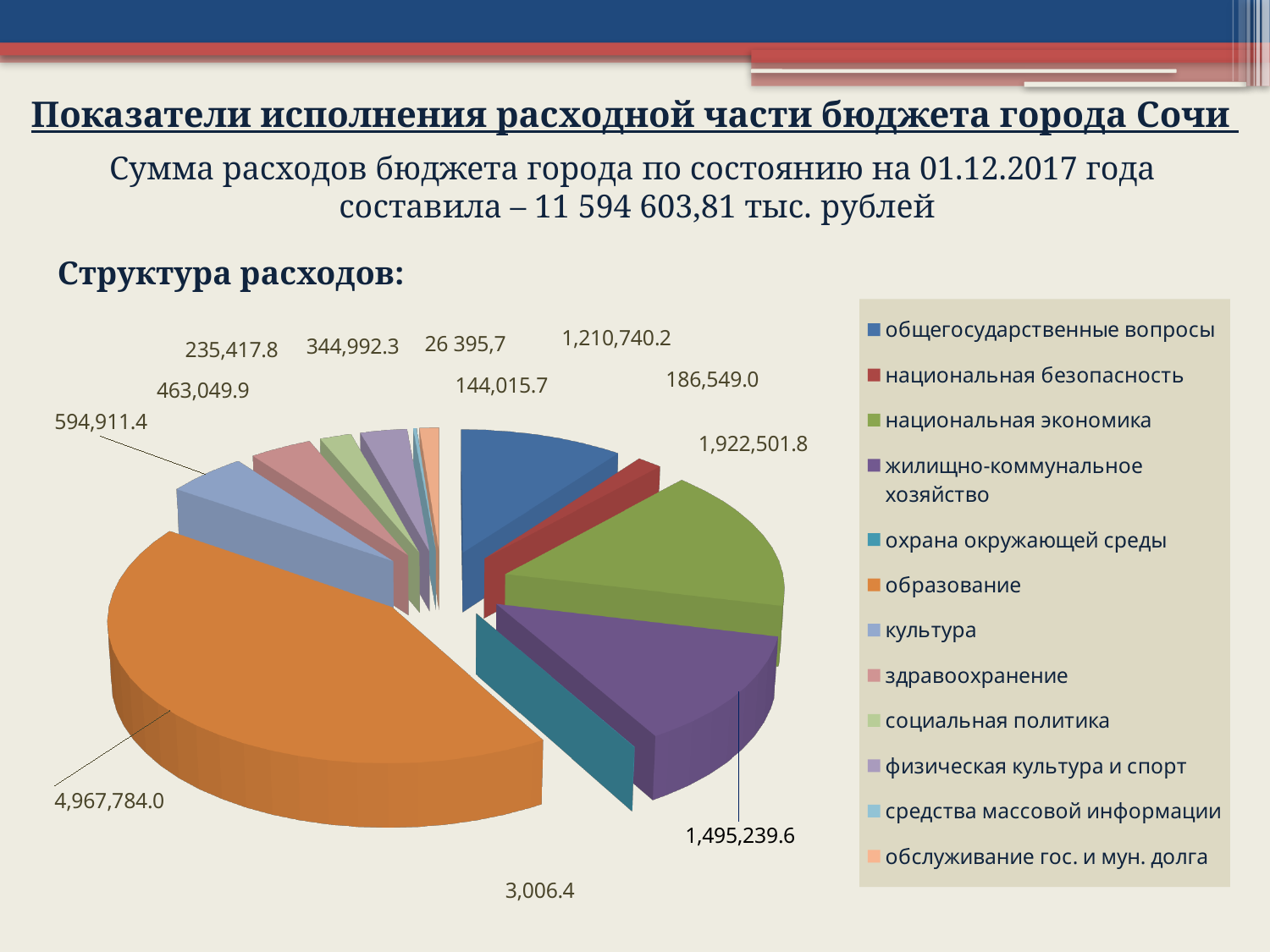
What kind of chart is shown on the slide? pie chart What colour is the slice for образование in the pie chart? orange What is the value shown for охрана окружающей среды? 3,006.4 What is the value shown for национальная экономика? 1,922,501.8 Which category has the smallest slice in the pie chart? охрана окружающей среды Which category has the largest slice in the pie chart? образование What is the difference between the values for национальная экономика and жилищно-коммунальное хозяйство? 427,262.2 Which is larger, национальная экономика or жилищно-коммунальное хозяйство? национальная экономика How many categories does the legend of the pie chart list? 12 What is the value shown for образование? 4,967,784.0 What is the value shown for жилищно-коммунальное хозяйство? 1,495,239.6 What is the value shown for общегосударственные вопросы? 1,210,740.2